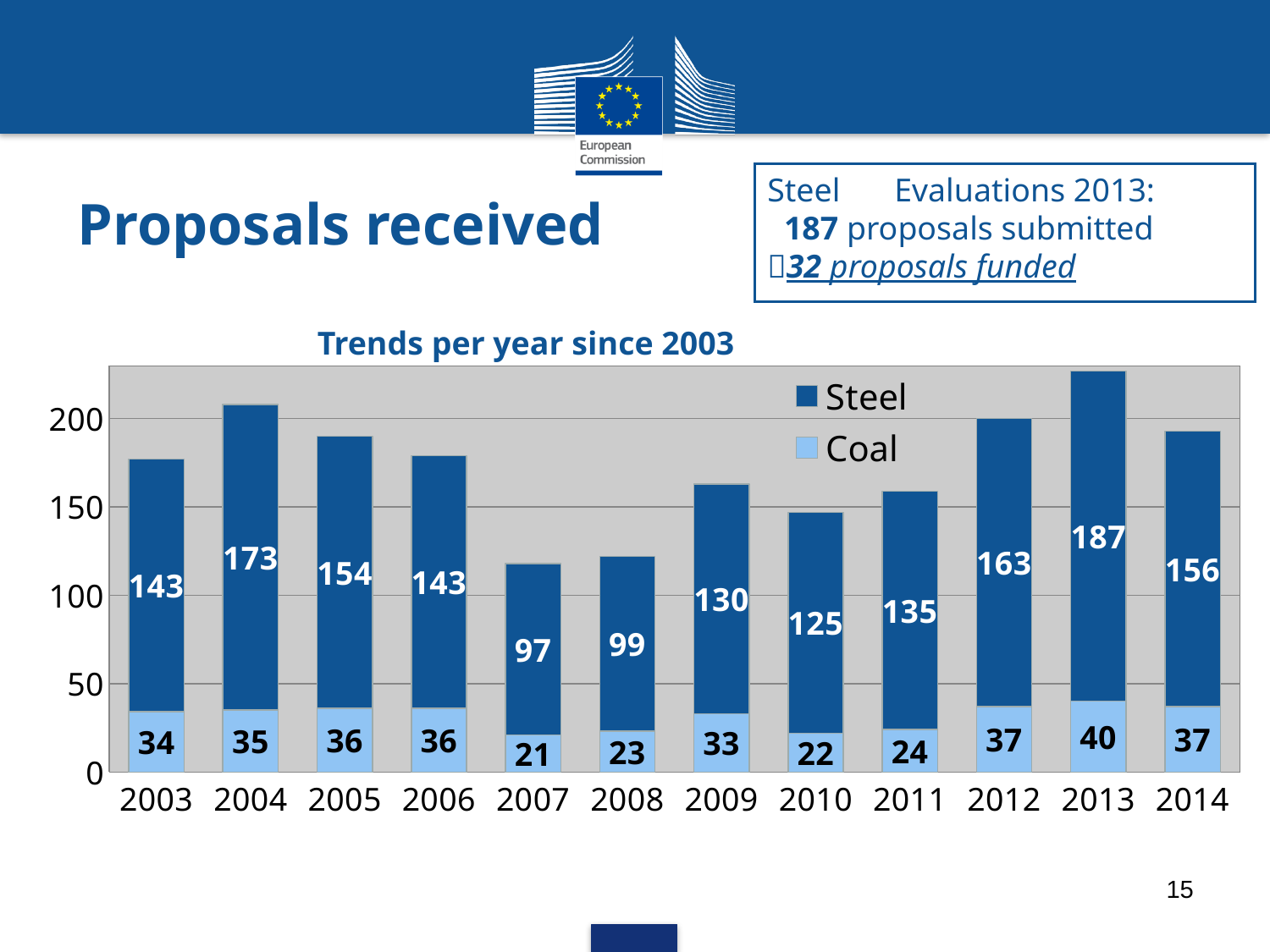
How many series does the legend of the 'Trends per year since 2003' chart list? 2 What kind of chart is 'Trends per year since 2003'? Stacked bar chart Which is larger in the 'Trends per year since 2003' chart: the Steel value for 2009 or the Steel value for 2011? 2011 What is the difference between the Steel values for 2004 and 2007 in the 'Trends per year since 2003' chart? 76 What is the total of the stacked bar for 2014 in the 'Trends per year since 2003' chart? 193 Which series is shown in dark blue in the 'Trends per year since 2003' chart? Steel Is the total stacked bar for 2013 in the 'Trends per year since 2003' chart greater or less than 200? greater What is the Coal value for 2007 in the 'Trends per year since 2003' chart? 21 Which year has the lowest Coal value in the 'Trends per year since 2003' chart? 2007 Which year has the highest Steel value in the 'Trends per year since 2003' chart? 2013 How many years are shown on the x axis of the 'Trends per year since 2003' chart? 12 What is the Steel value for 2013 in the 'Trends per year since 2003' chart? 187